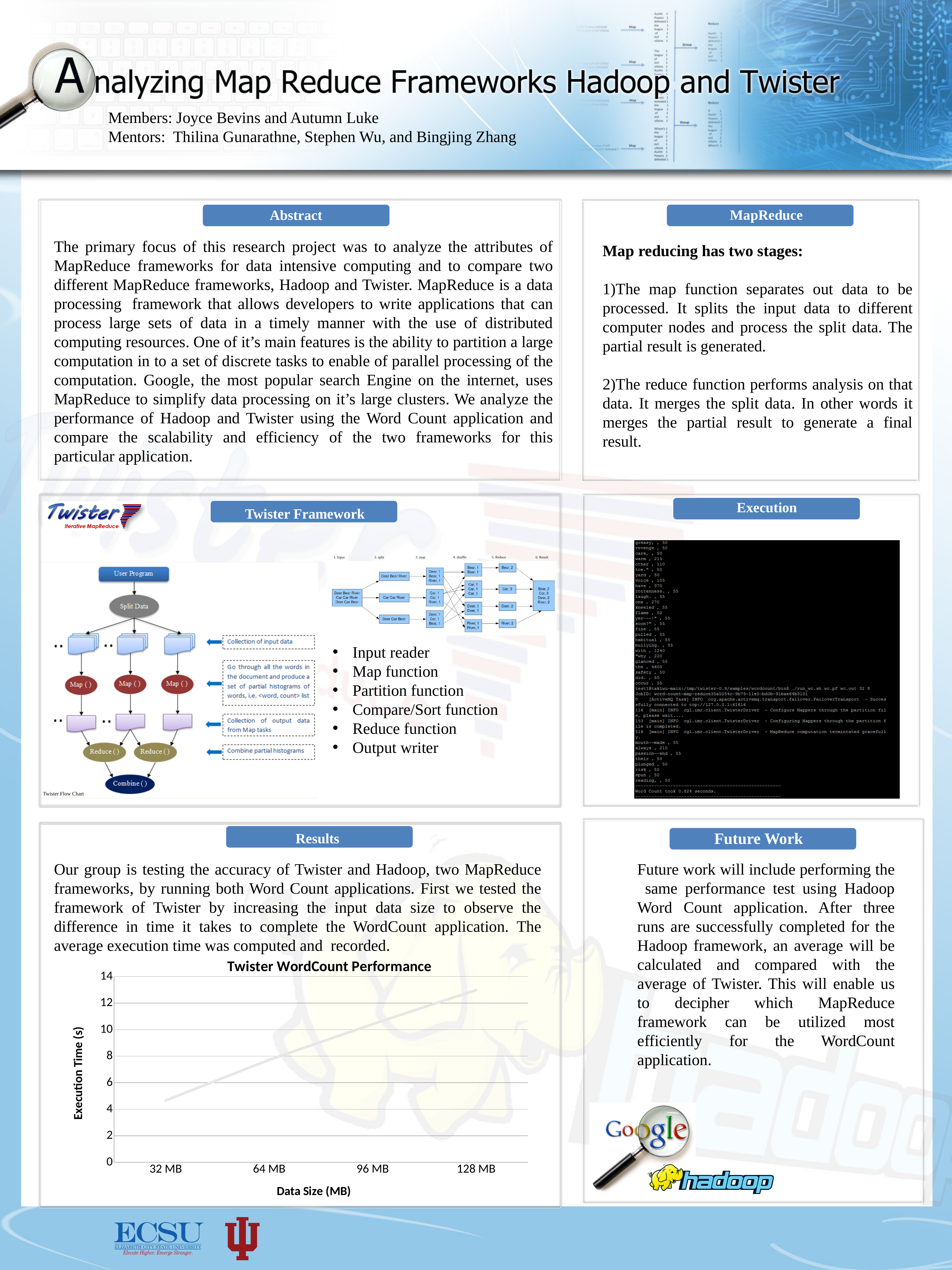
What is the label of the y axis on the Twister WordCount Performance chart? Execution Time (s) In the Twister WordCount Performance chart, is the execution time for 128 MB greater or less than 12? greater How many data size categories are shown on the x axis of the Twister WordCount Performance chart? 4 What kind of chart is the Twister WordCount Performance chart? line chart Which data size has the lowest execution time in the Twister WordCount Performance chart? 32 MB What is the title of the chart in the Results section? Twister WordCount Performance In the Twister WordCount Performance chart, is the execution time for 32 MB greater or less than 6? less Does execution time rise or fall as data size increases in the Twister WordCount Performance chart? rise Which data size has the highest execution time in the Twister WordCount Performance chart? 128 MB In the Twister WordCount Performance chart, which has the larger execution time, 64 MB or 128 MB? 128 MB In the Twister WordCount Performance chart, is the execution time for 96 MB greater or less than 8? greater